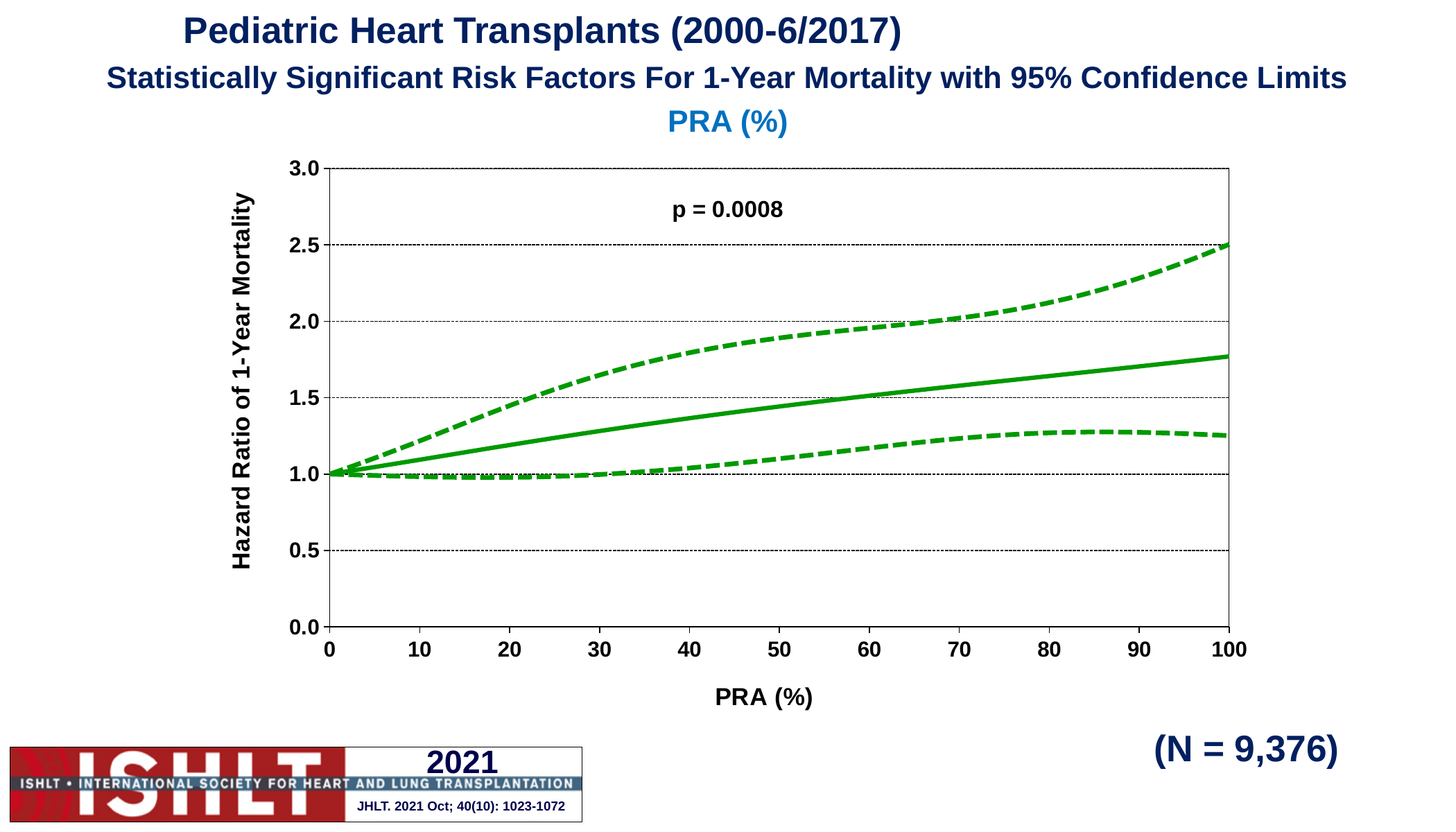
Is the hazard ratio (solid line) at a PRA of 100% greater or less than 2.0? less What p-value is printed on the chart? p = 0.0008 Is the hazard ratio (solid line) at a PRA of 100% greater or less than 1.5? greater What kind of chart is shown on the slide? line chart Is the upper 95% confidence limit (upper dashed line) at a PRA of 50% greater or less than 1.5? greater What value does the upper 95% confidence limit (upper dashed line) reach at a PRA of 100%? 2.5 What is the hazard ratio of 1-year mortality at a PRA of 0%? 1.0 Does the solid hazard ratio line rise or fall as PRA (%) increases from 0 to 100? rise What is the label of the y-axis of the chart? Hazard Ratio of 1-Year Mortality Which is larger at a PRA of 100%: the upper confidence limit or the solid hazard ratio line? the upper confidence limit